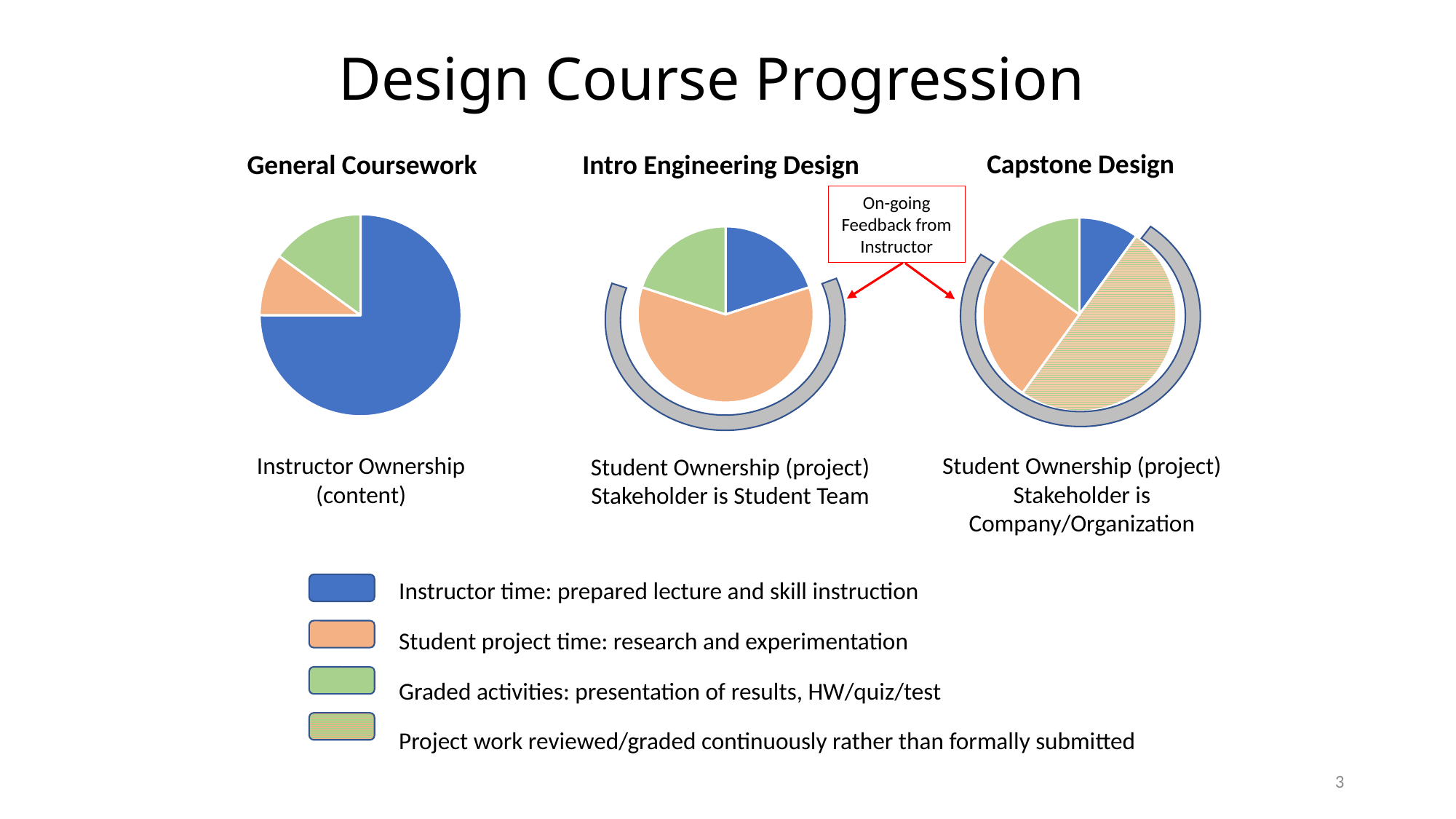
In the General Coursework pie chart, which is larger: the Instructor time slice or the Graded activities slice? Instructor time How many slices does the Capstone Design pie chart have? 4 In the Capstone Design pie chart, which category takes the largest share? Project work reviewed/graded continuously rather than formally submitted In the Capstone Design pie chart, which category takes the smallest share? Instructor time: prepared lecture and skill instruction What kind of chart is used under the heading General Coursework? pie chart In the General Coursework pie chart, which category takes the largest share? Instructor time: prepared lecture and skill instruction What colour represents Graded activities in the legend? green How many slices does the General Coursework pie chart have? 3 In the General Coursework pie chart, which category takes the smallest share? Student project time: research and experimentation How many slices does the Intro Engineering Design pie chart have? 3 How many entries does the legend at the bottom of the slide list? 4 In the Intro Engineering Design pie chart, which category takes the largest share? Student project time: research and experimentation